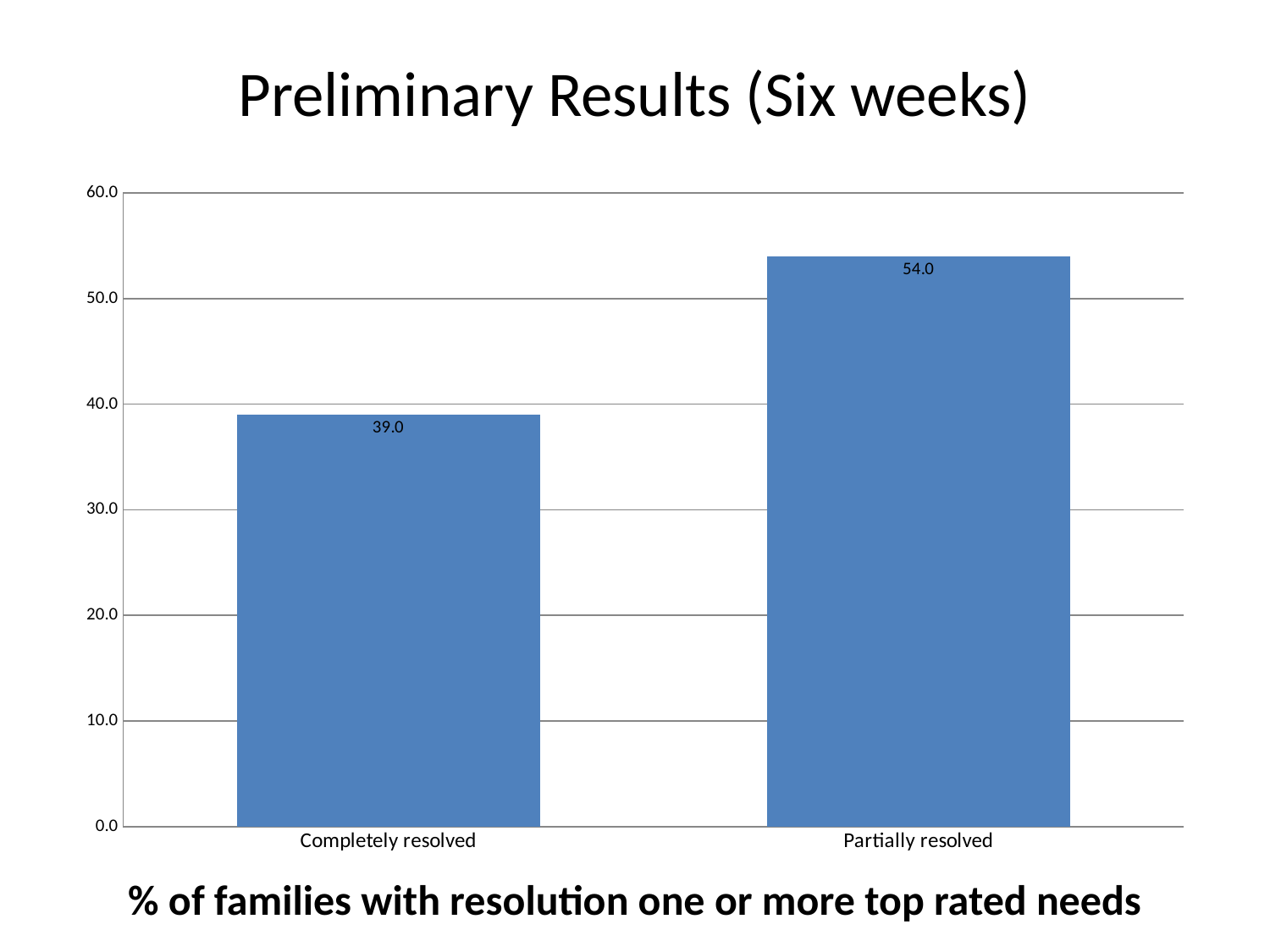
Is the value for Completely resolved greater or less than 40.0? less Which category has the highest value? Partially resolved Is the value for Partially resolved greater or less than 50.0? greater How many categories are shown in the chart? 2 What kind of chart is shown on the slide? bar chart What is the value for Partially resolved? 54.0 What is the value for Completely resolved? 39.0 What is the highest value shown on the vertical axis? 60.0 Which category has the lowest value? Completely resolved What is the title of the slide? Preliminary Results (Six weeks) What is the difference between the values for Partially resolved and Completely resolved? 15.0 Which is larger, the value for Completely resolved or the value for Partially resolved? Partially resolved